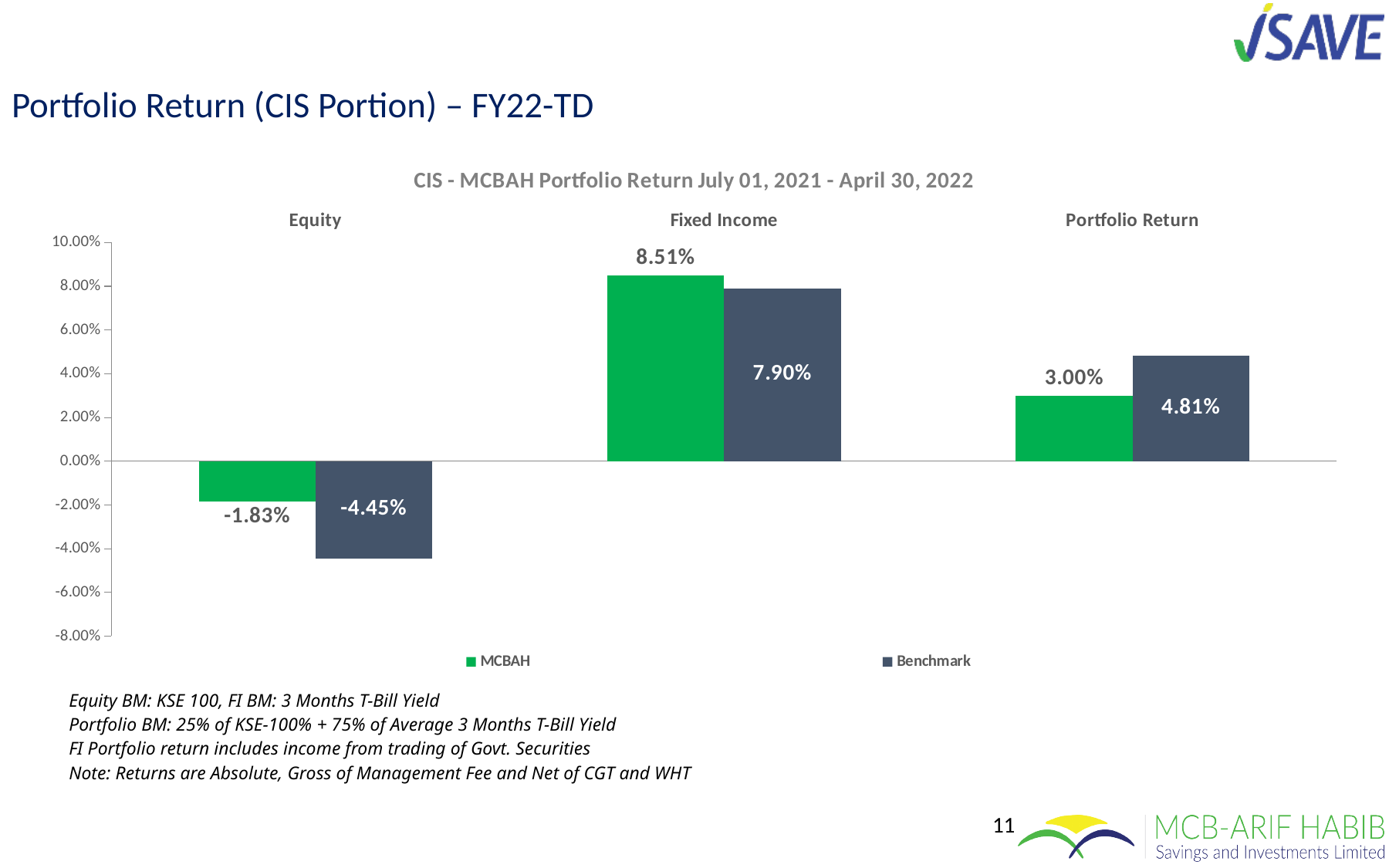
What is the Benchmark value for Equity? -4.45% What is the title of the chart? CIS - MCBAH Portfolio Return July 01, 2021 - April 30, 2022 What is the MCBAH value for Equity? -1.83% Which is larger for Portfolio Return, the MCBAH value or the Benchmark value? Benchmark Which category has the lowest Benchmark value? Equity How many series does the legend list? 2 How many categories are shown on the x axis? 3 What kind of chart is shown on the slide? Bar chart What is the MCBAH value for Portfolio Return? 3.00% What is the difference between the MCBAH and Benchmark values for Fixed Income? 0.61% Which category has the highest MCBAH value? Fixed Income What is the Benchmark value for Fixed Income? 7.90%